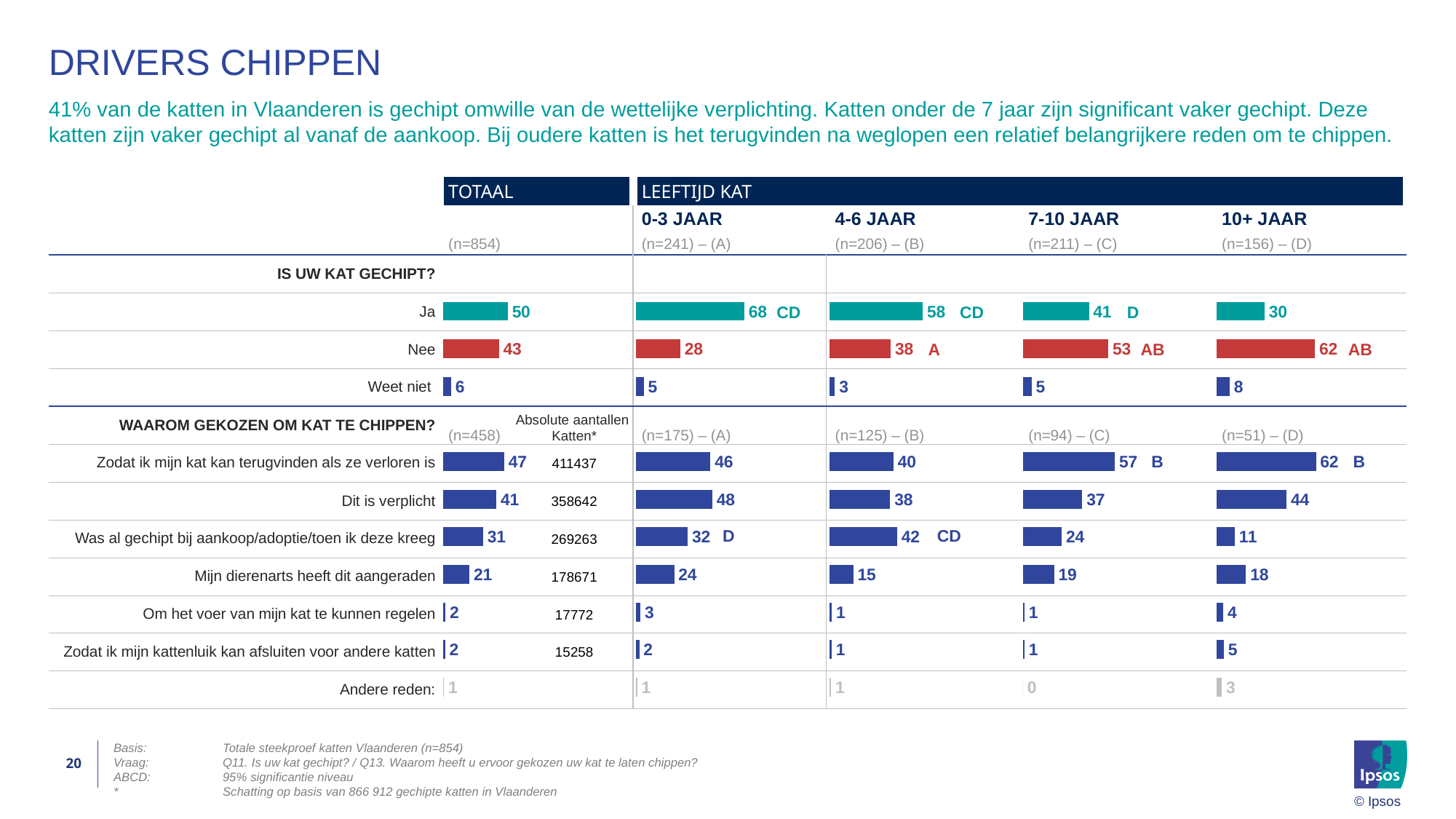
What type of chart is used to display the values in the table? Bar chart In the TOTAAL column, what is the value for 'Dit is verplicht' under 'Waarom gekozen om kat te chippen?' 41 In the 4-6 JAAR column, which reason for chipping has the highest value? Was al gechipt bij aankoop/adoptie/toen ik deze kreeg In the TOTAAL column, what percentage answered 'Ja' to 'Is uw kat gechipt?' 50 How does the value for 'Ja' under 'Is uw kat gechipt?' change as the cat's age group increases from 0-3 JAAR to 10+ JAAR? It falls Which age group has the highest value for 'Ja' under 'Is uw kat gechipt?' 0-3 JAAR Which age group has the lowest value for 'Ja' under 'Is uw kat gechipt?' 10+ JAAR In the 7-10 JAAR column, is the value for 'Zodat ik mijn kat kan terugvinden als ze verloren is' larger or smaller than in the 0-3 JAAR column? larger What is the absolute number of cats (Absolute aantallen Katten) for 'Zodat ik mijn kat kan terugvinden als ze verloren is'? 411437 In the TOTAAL column, what is the difference between 'Ja' and 'Nee' under 'Is uw kat gechipt?' 7 In the 10+ JAAR column, what is the value for 'Nee' under 'Is uw kat gechipt?' 62 In the 0-3 JAAR column, what is the value for 'Ja' under 'Is uw kat gechipt?' 68